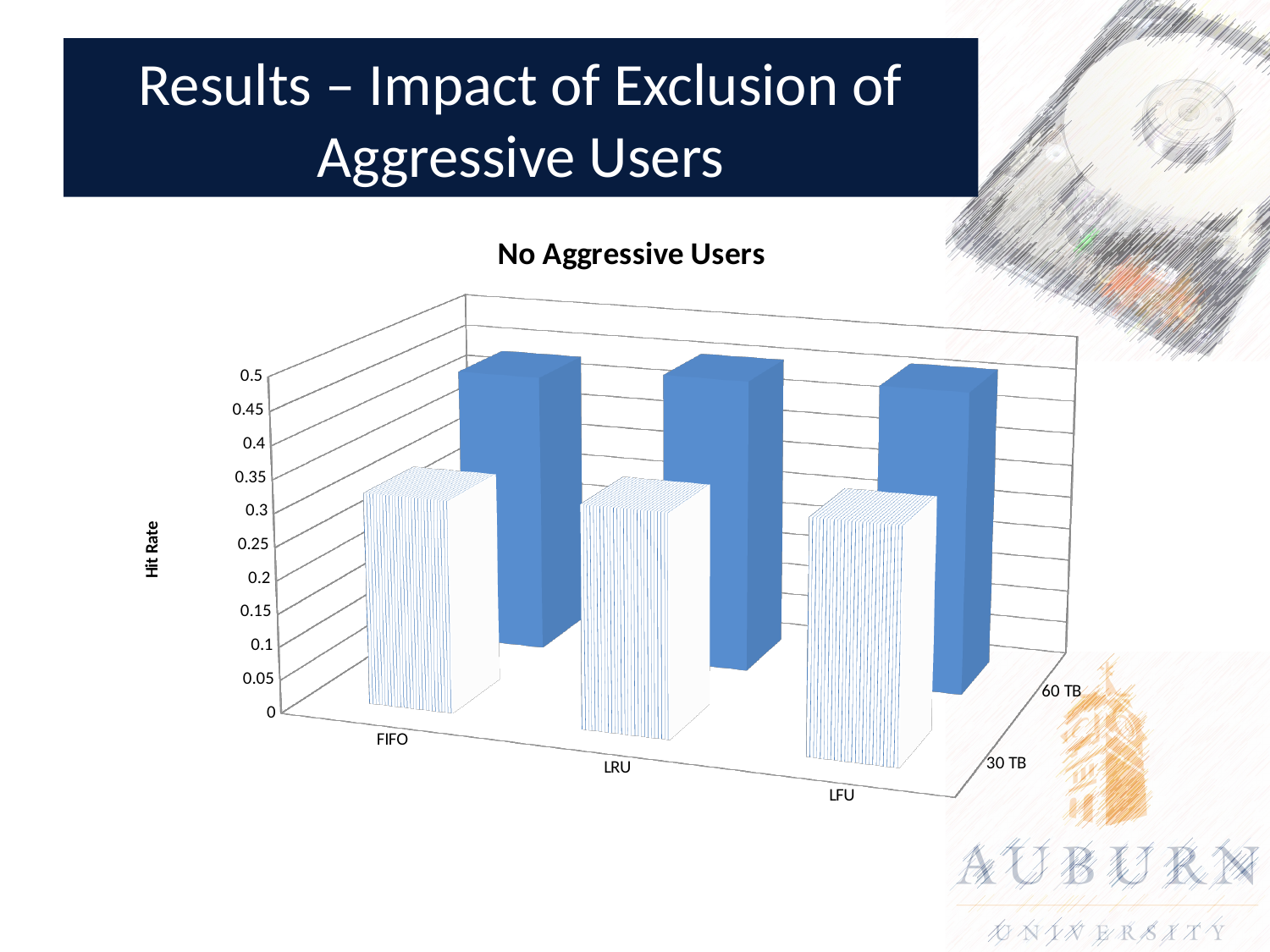
Is the hit rate for FIFO at 60 TB greater or less than 0.2? greater What is the maximum value shown on the Hit Rate axis? 0.5 For LRU, which cache size has the higher hit rate, 30 TB or 60 TB? 60 TB What is the title of the chart? No Aggressive Users For FIFO, which cache size has the higher hit rate, 30 TB or 60 TB? 60 TB What is the label on the vertical axis of the chart? Hit Rate What kind of chart is shown on the slide? bar chart Is the hit rate for LFU at 30 TB greater or less than 0.1? greater How many cache replacement policies are shown along the horizontal axis of the chart? 3 How many cache sizes are shown on the depth axis of the chart? 2 For LFU, which cache size has the higher hit rate, 30 TB or 60 TB? 60 TB